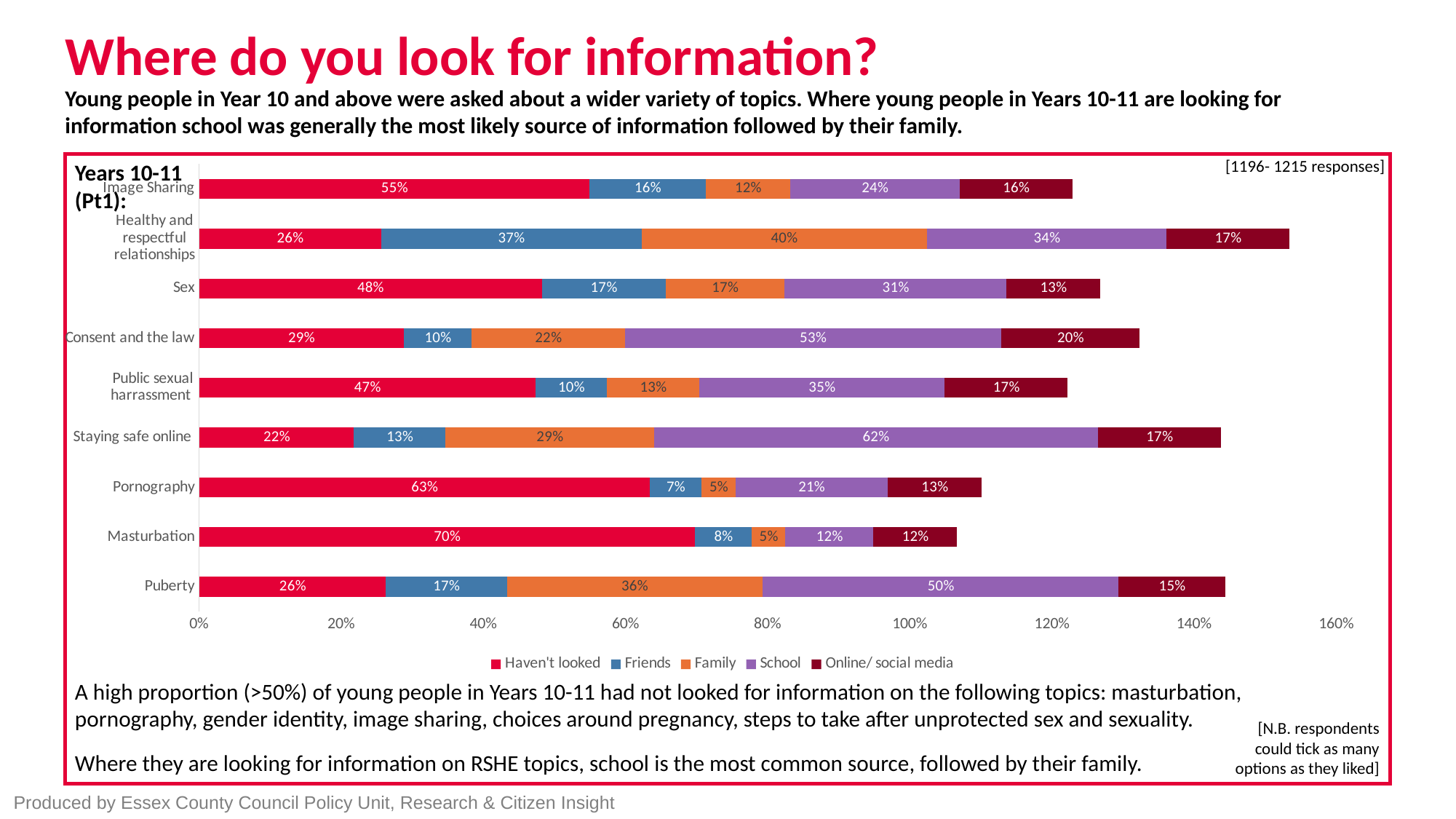
How many topics (categories) are plotted on the chart? 9 How many series does the legend list? 5 Which topic has the highest 'Haven't looked' value? Masturbation What is the Family value for Healthy and respectful relationships? 40% Which topic has the lowest 'Haven't looked' value? Staying safe online What is the total of the stacked bar for Puberty? 144% What percentage of Years 10-11 respondents had not looked for information on Masturbation? 70% Which series is shown in purple in the legend? School What is the School value for Staying safe online? 62% What is the difference between the School values for Consent and the law and Sex? 22% What kind of chart is shown on the slide? Stacked bar chart Which is larger: the Friends value for Healthy and respectful relationships or the Friends value for Puberty? Healthy and respectful relationships